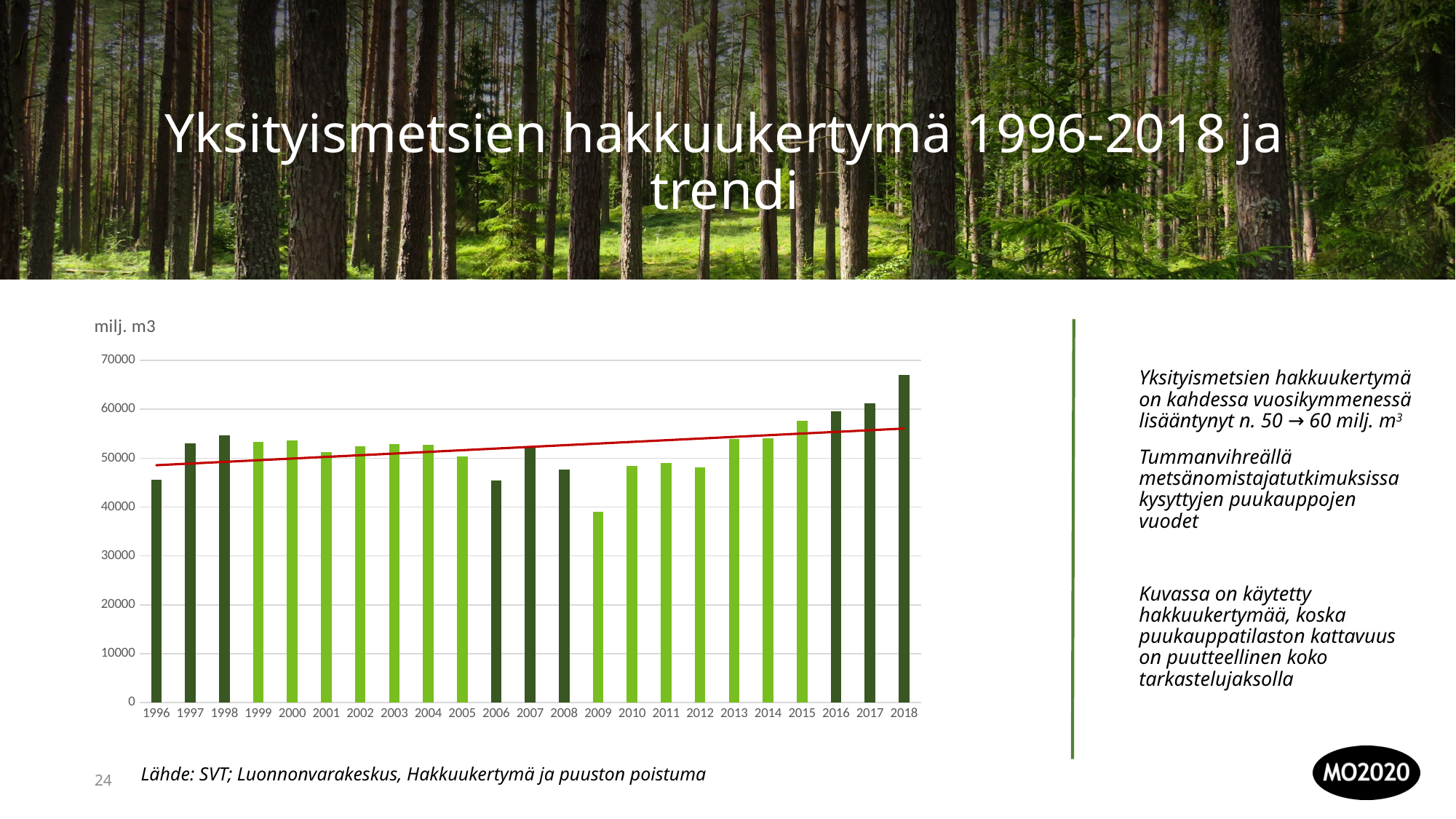
Is the value for 2009 greater or less than 40000? less Does the red trend line rise or fall from 1996 to 2018? rises Is the value for 2015 greater or less than 50000? greater Which is larger, the value for 2018 or the value for 1996? 2018 Which year has the highest bar in the chart? 2018 What unit is shown above the vertical axis of the chart? milj. m3 Is the value for 2018 greater or less than 60000? greater How many years are plotted on the x axis of the chart? 23 Which is larger, the value for 2013 or the value for 2009? 2013 Which year has the lowest bar in the chart? 2009 What kind of chart is shown on the slide? bar chart